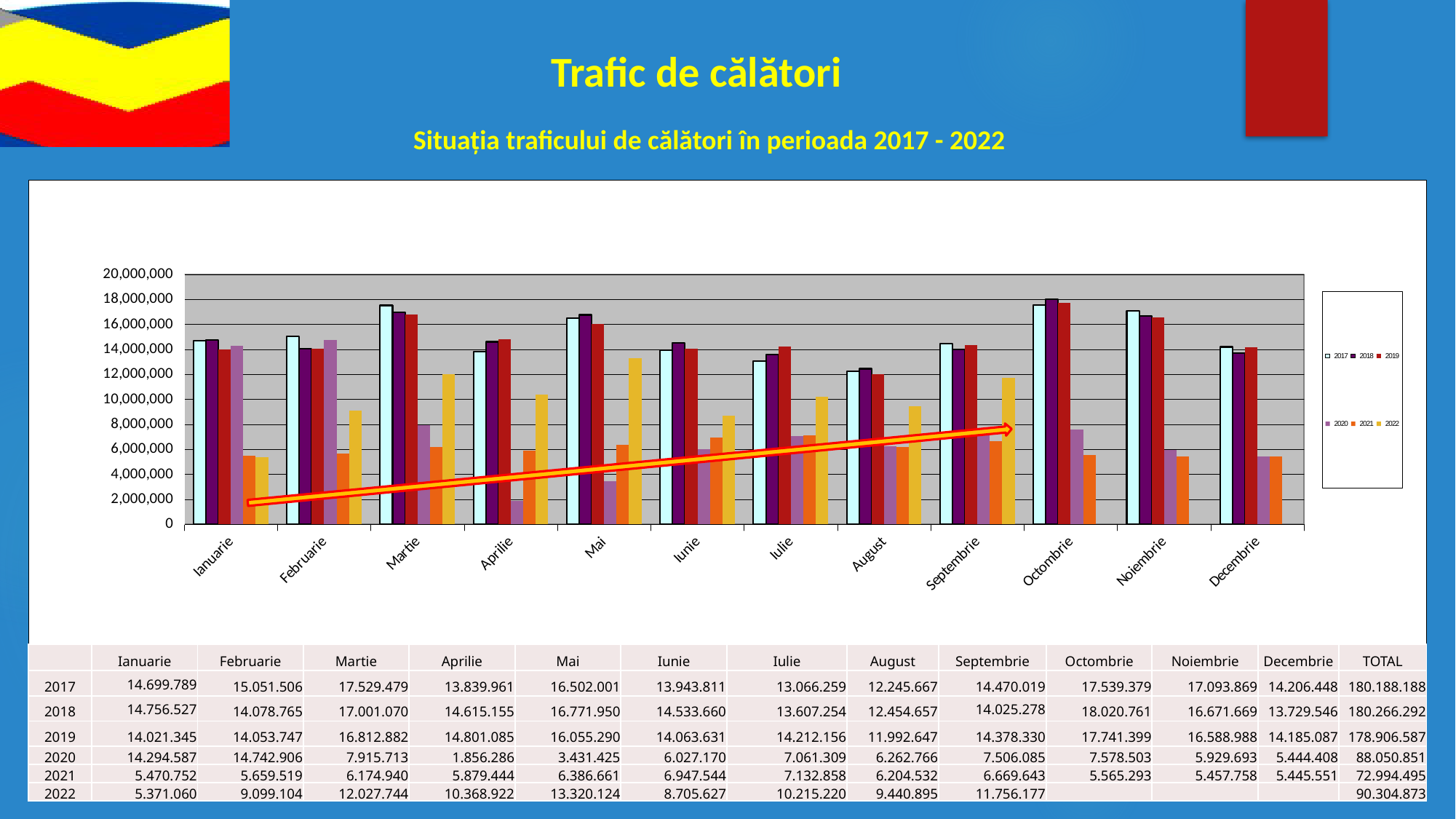
What is the difference between the TOTAL for 2018 and the TOTAL for 2017? 78.104 Which is larger in Februarie: the value for 2020 or the value for 2021? 2020 In which month is the 2018 value highest? Octombrie What is the difference between the 2022 values for Mai and Aprilie? 2.951.202 What is the value for 2018 in Octombrie? 18.020.761 What is the TOTAL for 2021? 72.994.495 What kind of chart is shown on the slide? bar chart Do the 2022 values rise or fall from Ianuarie to Martie? rise How many series does the chart's legend list? 6 In which month is the 2020 value lowest? Aprilie How many months are shown along the x axis of the chart? 12 Is the value for 2022 in Mai greater or less than 12,000,000? greater